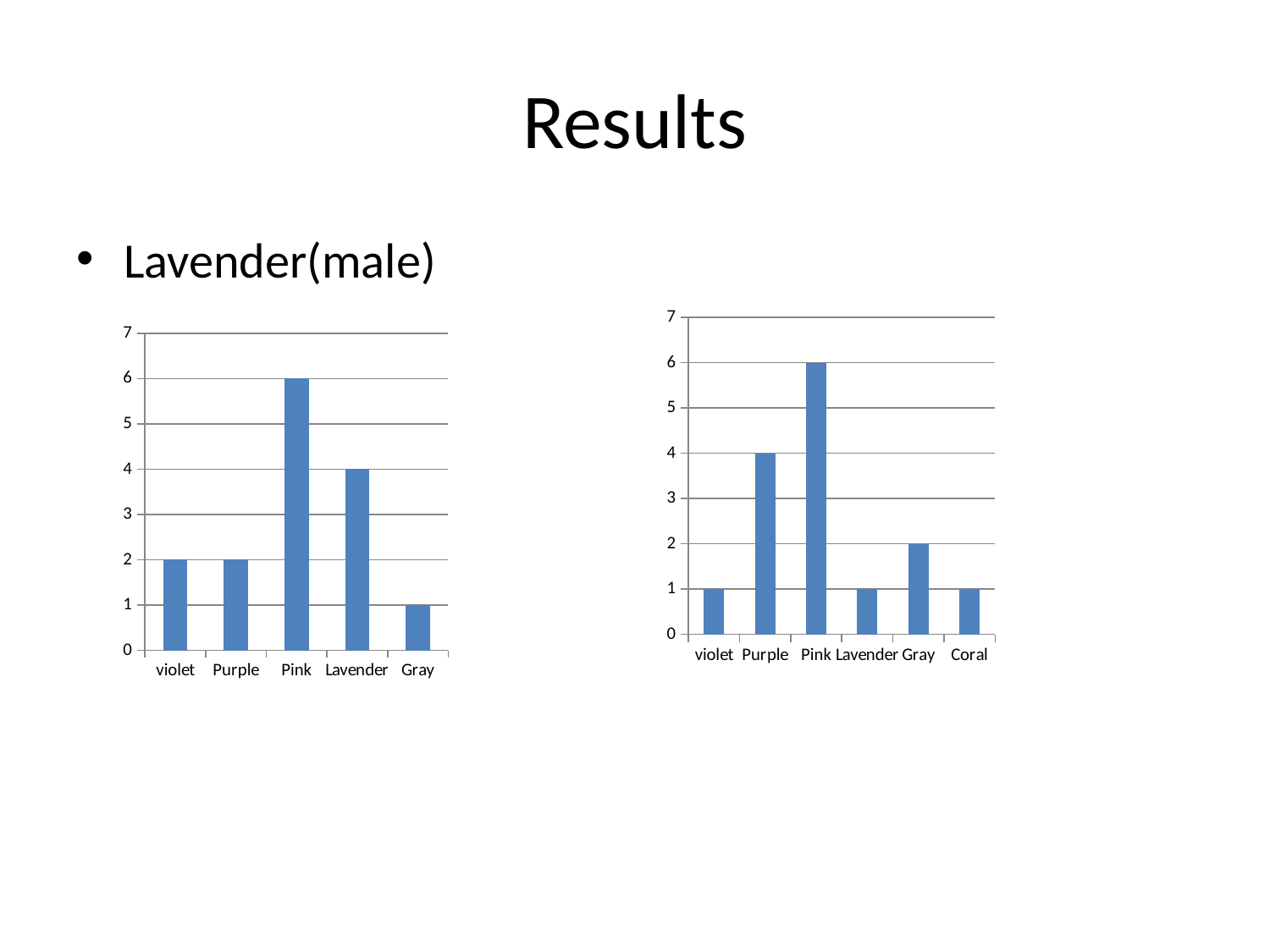
In the left chart, which category has the lowest value? Gray In the right chart, which is larger, the value for Purple or the value for Gray? Purple In the left chart, which category has the highest value? Pink In the left chart, how many categories are shown on the x axis? 5 In the right chart, what is the value for Gray? 2 In the left chart, what is the value for Pink? 6 What kind of chart is the right chart? Bar chart In the right chart, what is the value for Purple? 4 In the left chart, what is the value for Lavender? 4 In the right chart, how many categories are shown on the x axis? 6 In the left chart, what is the difference between the values for Pink and Lavender? 2 In the right chart, which category has the highest value? Pink